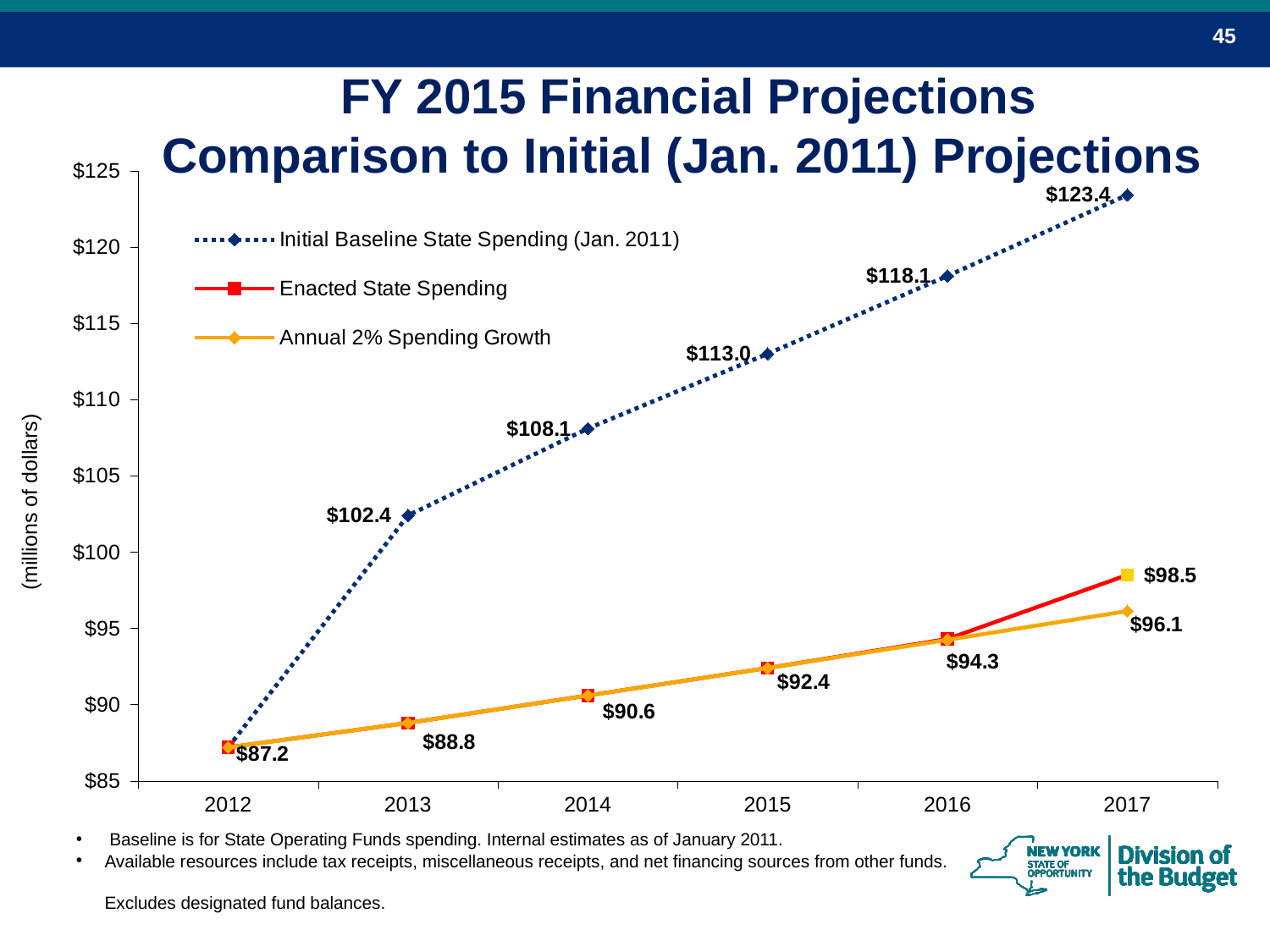
How many series does the legend list? 3 What is the Initial Baseline State Spending (Jan. 2011) value for 2014? $108.1 What is the difference between Enacted State Spending and Annual 2% Spending Growth in 2017? $2.4 What is the Enacted State Spending value for 2017? $98.5 How many years are shown on the x axis? 6 What kind of chart is shown on the slide? Line chart What is the Annual 2% Spending Growth value for 2017? $96.1 What is the Initial Baseline State Spending (Jan. 2011) value for 2017? $123.4 In which year is the Initial Baseline State Spending (Jan. 2011) highest? 2017 In 2017, which is larger: Enacted State Spending or Annual 2% Spending Growth? Enacted State Spending What is the difference between the Initial Baseline State Spending and the Enacted State Spending in 2017? $24.9 Does the Initial Baseline State Spending (Jan. 2011) line rise or fall from 2012 to 2017? Rise